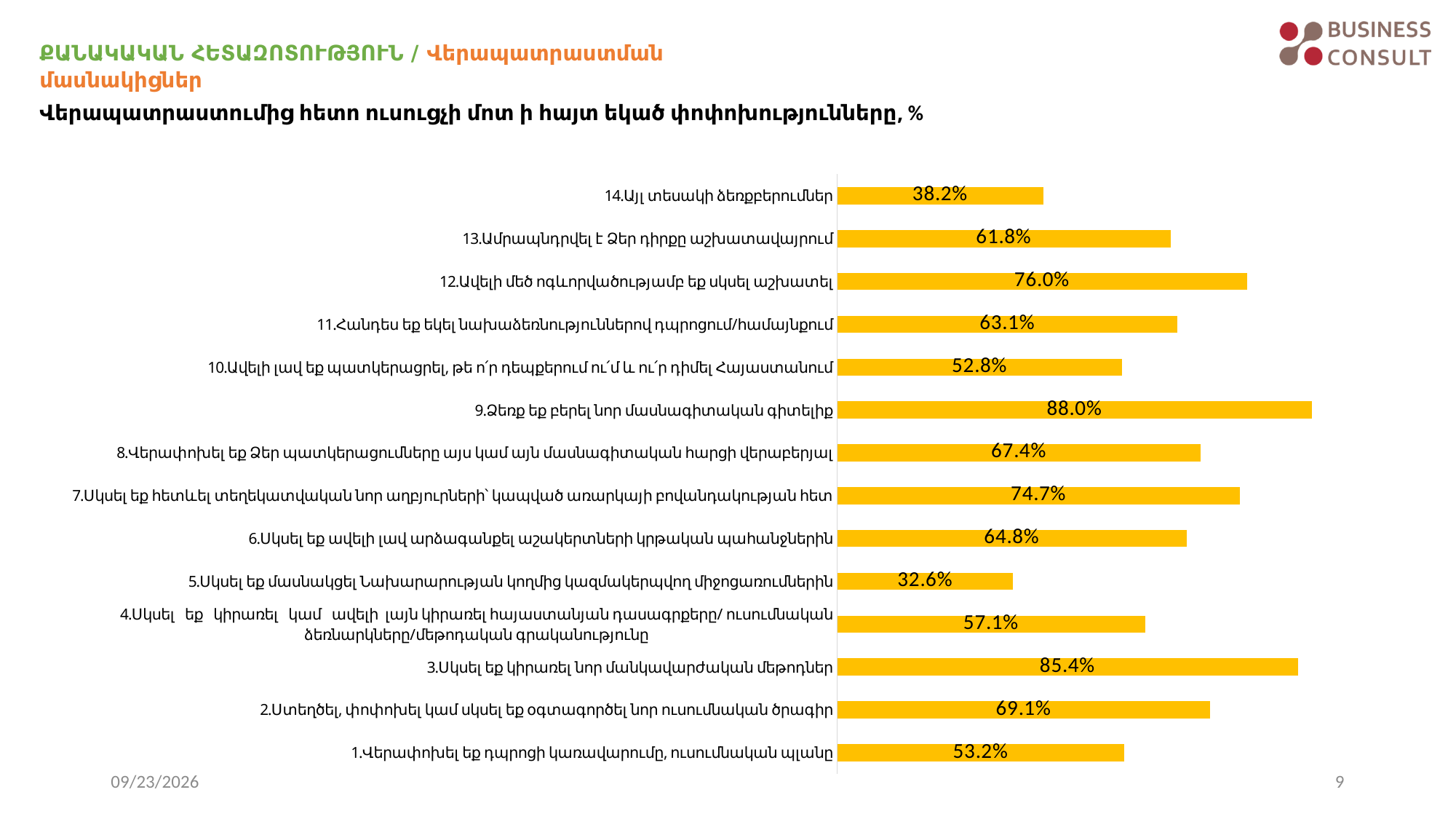
What kind of chart is shown on the slide? bar chart What is the difference between the values for category 12 and category 13? 14.2% What is the value for category 3 (Սկսել եք կիրառել նոր մանկավարժական մեթոդներ)? 85.4% What is the value for category 1 (Վերափոխել եք դպրոցի կառավարումը, ուսումնական պլանը)? 53.2% How many categories are shown in the chart? 14 What is the difference between the values for category 9 and category 5? 55.4% What is the value for category 9 (Ձեռք եք բերել նոր մասնագիտական գիտելիք)? 88.0% Which is larger, the value for category 7 or the value for category 8? category 7 What is the title of the chart? Վերապատրաստումից հետո ուսուցչի մոտ ի հայտ եկած փոփոխությունները, % Which category has the lowest value? 5.Սկսել եք մասնակցել Նախարարության կողմից կազմակերպվող միջոցառումներին What is the value for category 14 (Այլ տեսակի ձեռքբերումներ)? 38.2% Which category has the highest value? 9.Ձեռք եք բերել նոր մասնագիտական գիտելիք